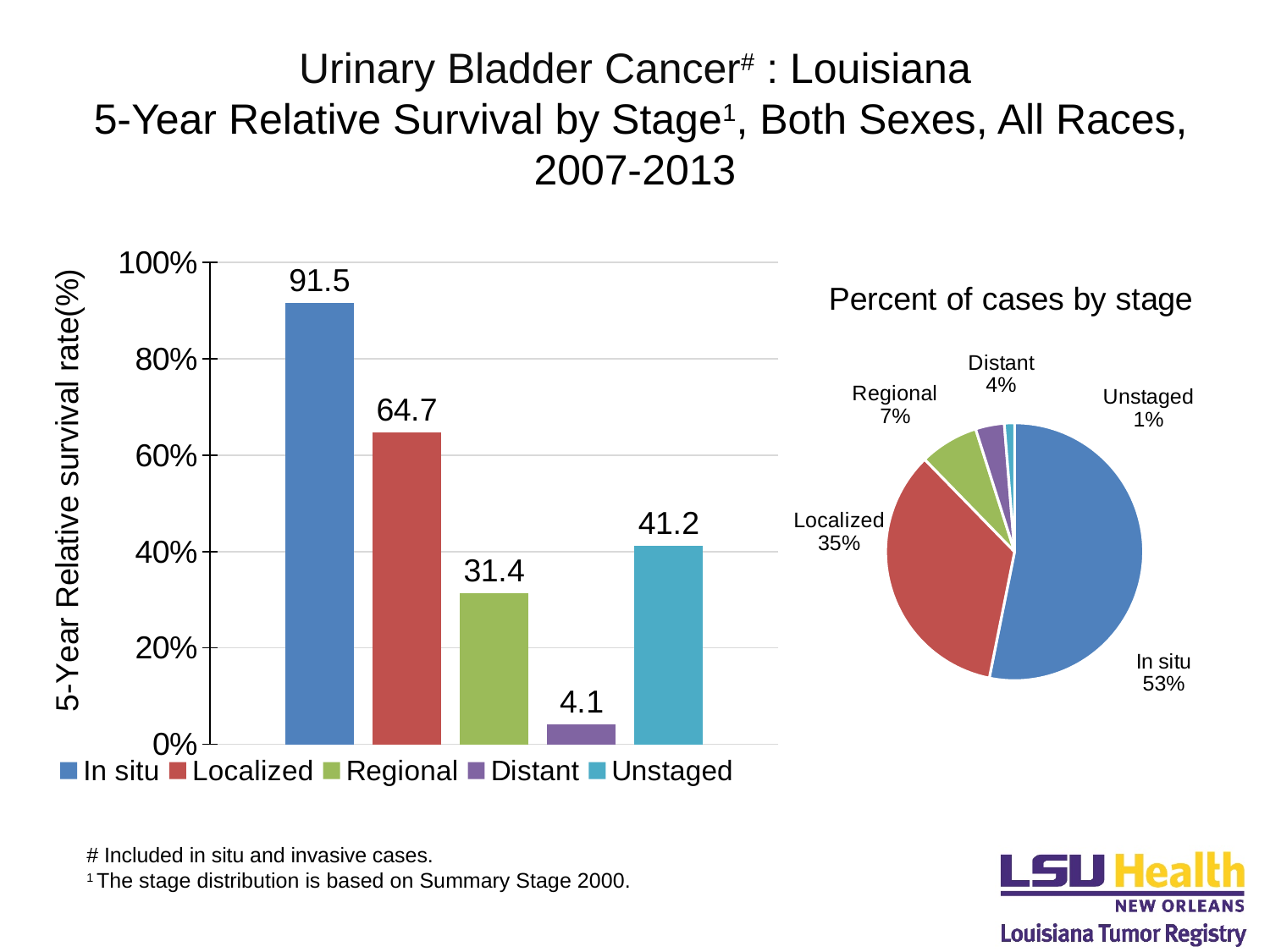
In the 'Percent of cases by stage' pie chart, which stage has the smallest share of cases? Unstaged In the bar chart on the left, what is the 5-year relative survival rate for the Distant stage? 4.1 In the bar chart on the left, what is the 5-year relative survival rate for the Localized stage? 64.7 In the bar chart on the left, which stage has the lowest 5-year relative survival rate? Distant In the bar chart on the left, how many stage categories are plotted? 5 In the bar chart on the left, what is the difference between the survival rates for In situ and Localized? 26.8 In the bar chart on the left, which stage has the highest 5-year relative survival rate? In situ In the bar chart on the left, which has a higher survival rate, Regional or Unstaged? Unstaged What kind of chart is the 'Percent of cases by stage' chart on the right? Pie chart In the 'Percent of cases by stage' pie chart, what share of cases is Localized? 35% In the bar chart on the left, how many entries does the legend list? 5 In the 'Percent of cases by stage' pie chart, which stage has the largest share of cases? In situ